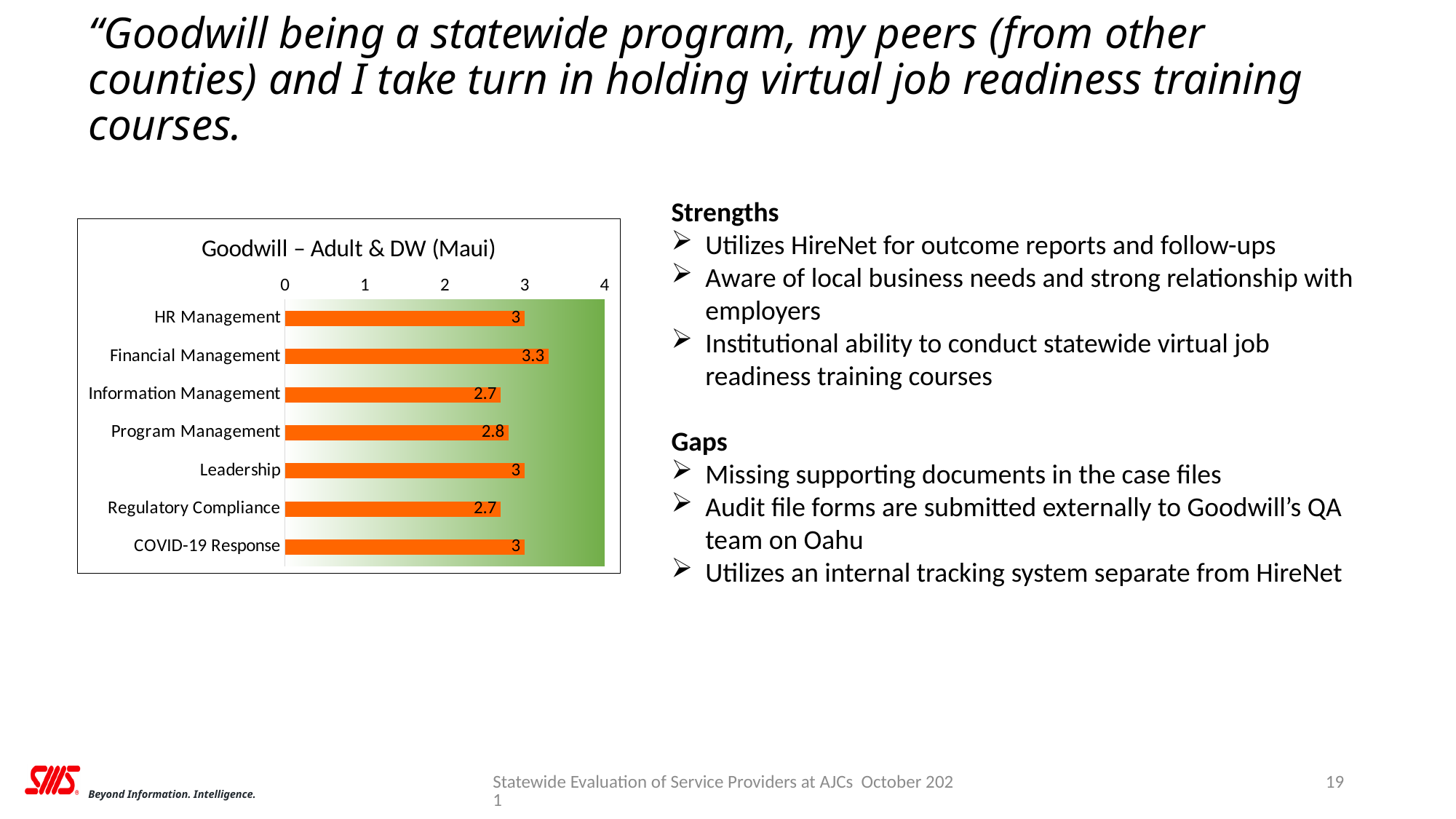
What is the value for COVID-19 Response? 3 Which category has the highest value? Financial Management What is the value for Program Management? 2.8 What is the title of the chart? Goodwill – Adult & DW (Maui) What is the maximum value shown on the chart's axis? 4 What kind of chart is shown on the slide? bar chart What is the value for Regulatory Compliance? 2.7 Is the value for Financial Management greater or less than 3? greater How many categories are shown in the chart? 7 What is the difference between the values for Financial Management and Information Management? 0.6 What is the value for Financial Management? 3.3 Which is larger, the value for Program Management or the value for Regulatory Compliance? Program Management